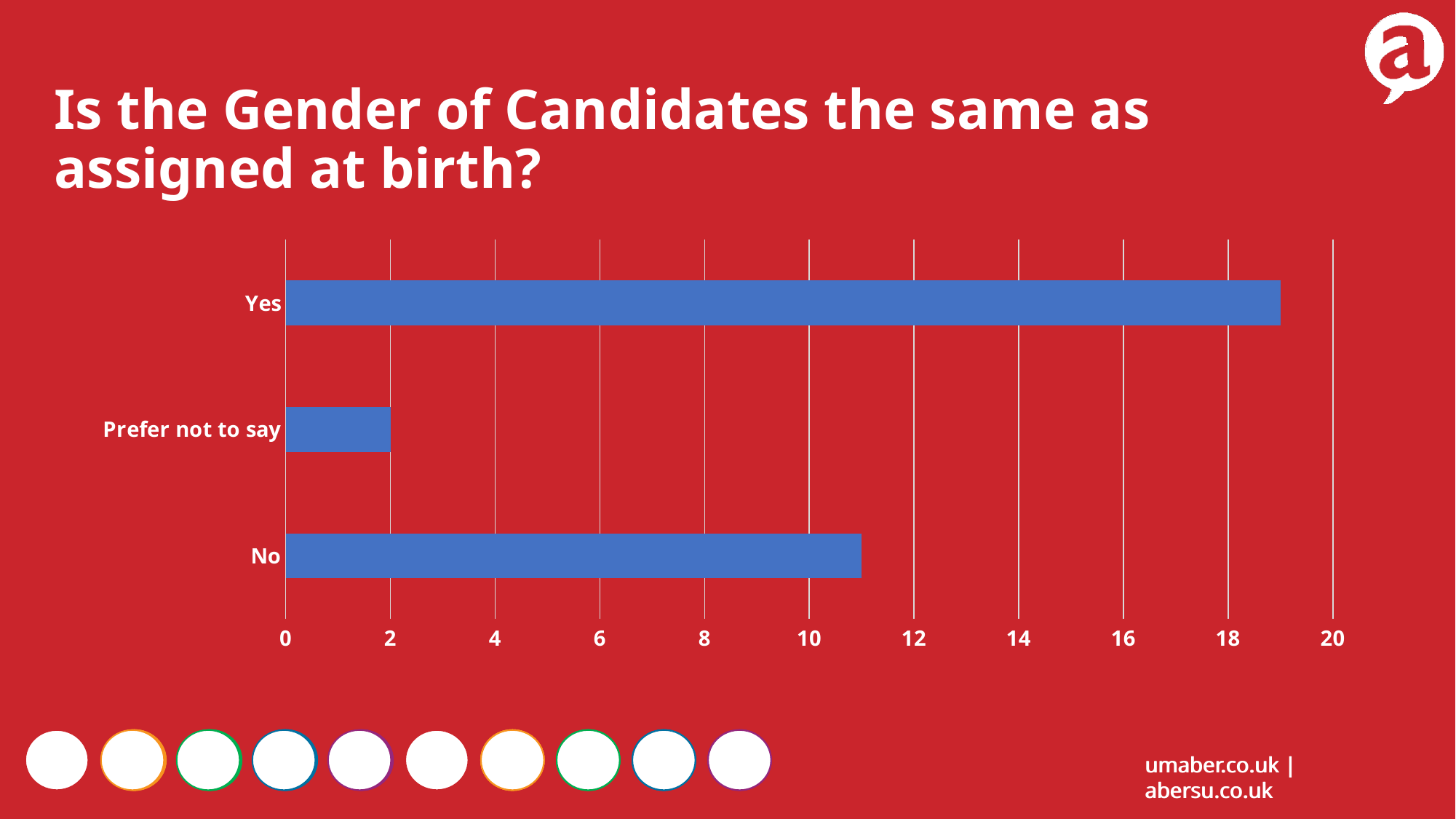
What is the title of the slide containing the chart? Is the Gender of Candidates the same as assigned at birth? Which category has the lowest value? Prefer not to say Is the value for "Yes" greater or less than 18? greater Which category has the highest value? Yes Which is larger, the value for "Yes" or the value for "No"? Yes What is the value for "Prefer not to say"? 2 Is the value for "No" greater or less than 12? less What kind of chart is shown on the slide? bar chart Is the value for "No" greater or less than 10? greater How many categories are shown in the chart? 3 Which is larger, the value for "No" or the value for "Prefer not to say"? No What is the maximum value shown on the horizontal axis? 20